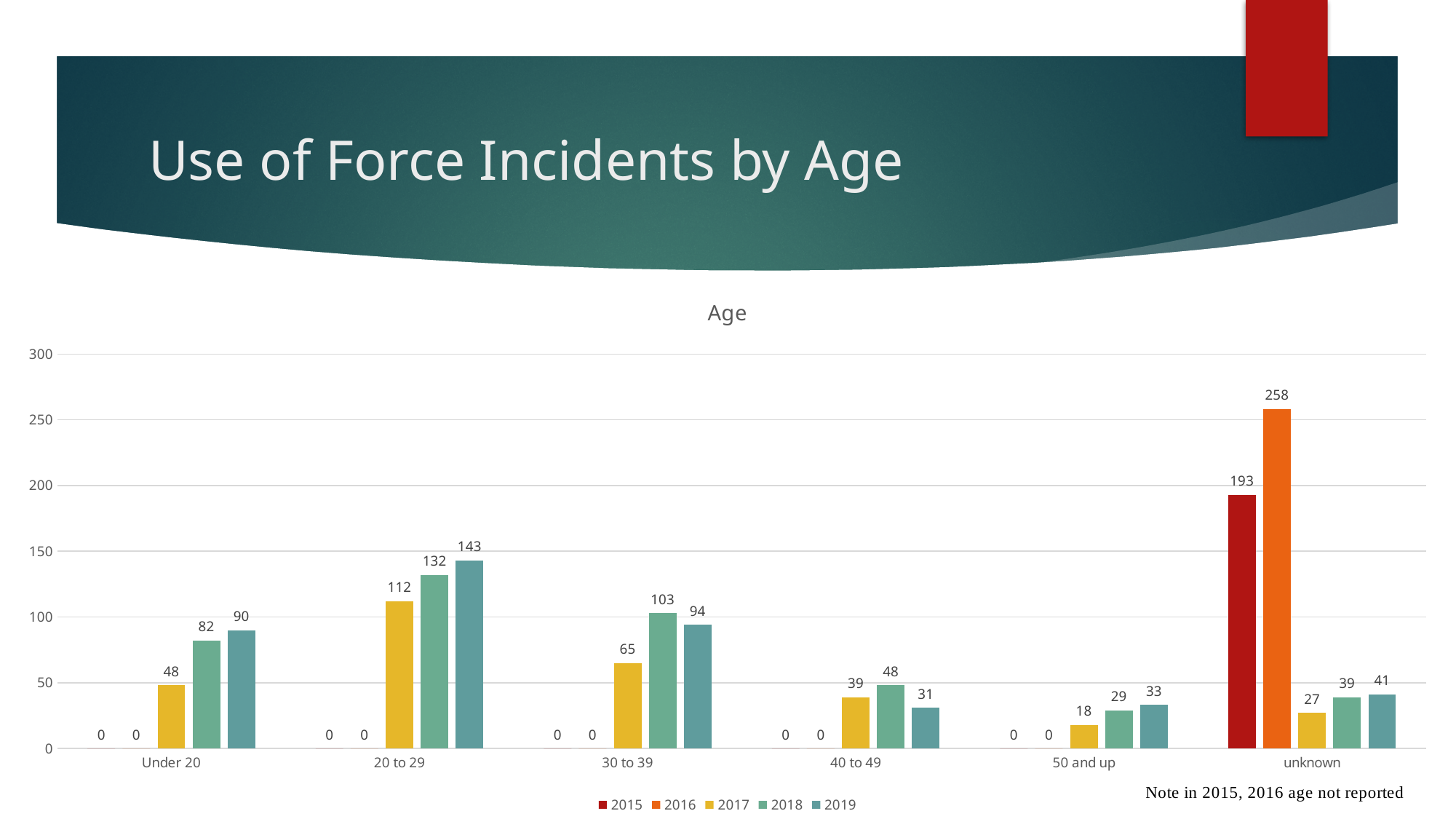
What is the title of the chart? Age Which age category has the lowest value for 2019? 40 to 49 What kind of chart is shown on the slide? bar chart What is the difference between the 2019 and 2018 values for the Under 20 age group? 8 What is the value for 2019 in the 20 to 29 age group? 143 Which is larger, the 2018 value for 30 to 39 or the 2019 value for 30 to 39? 2018 value for 30 to 39 What is the difference between the 2016 and 2015 values for the unknown age category? 65 How many age categories are shown on the x axis? 6 What is the value for 2017 in the 30 to 39 age group? 65 Which age category has the highest value for 2018? 20 to 29 How many series does the legend list? 5 What is the value for 2016 in the unknown age category? 258